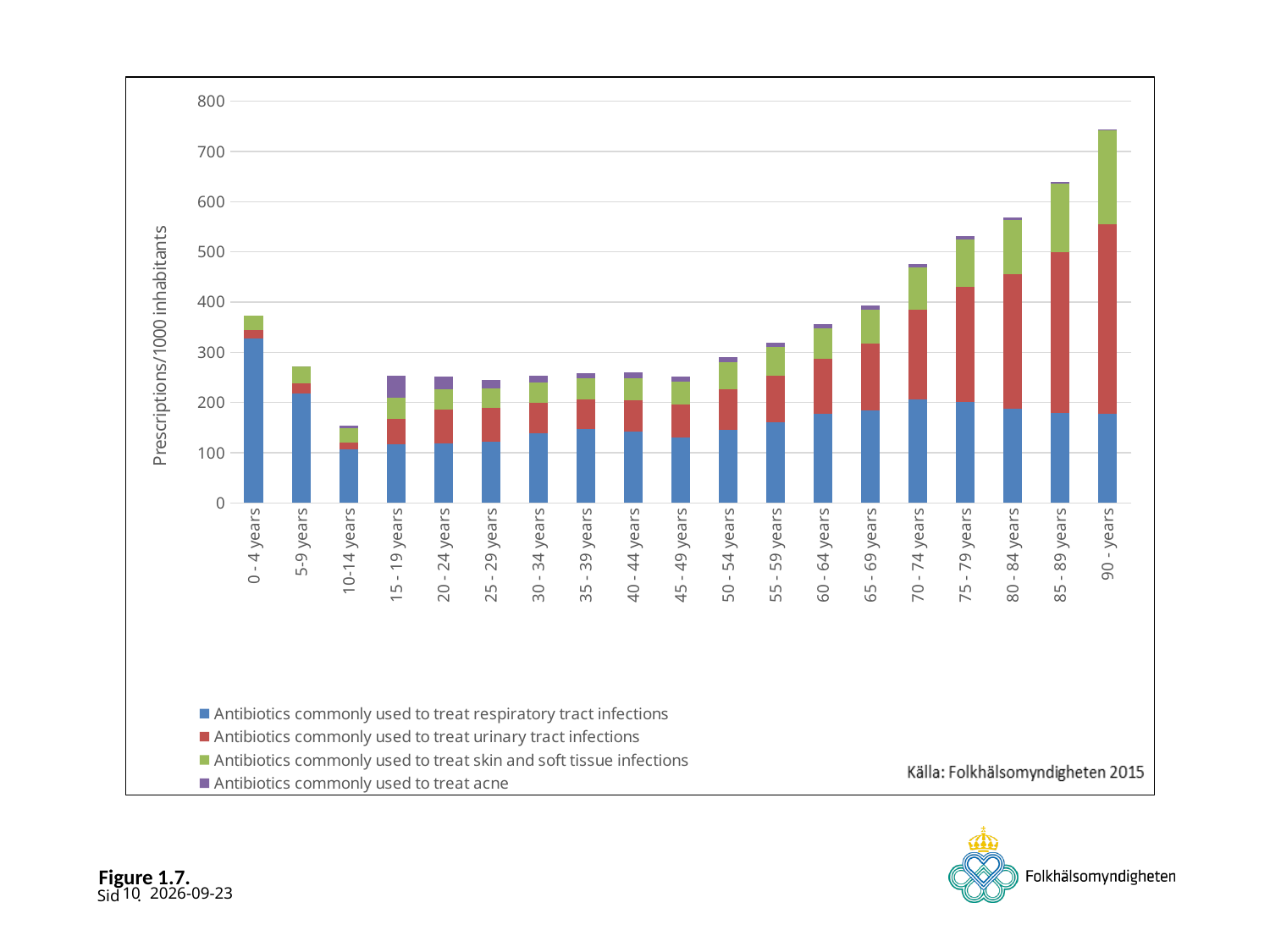
Is the total value for 90 - years greater or less than 700? greater Is the total value for 10-14 years greater or less than 200? less How many age-group categories are shown on the x axis? 19 What kind of chart is shown on the slide? Stacked bar chart Which age group has the highest value for antibiotics commonly used to treat respiratory tract infections? 0 - 4 years How many series does the legend list? 4 Which age group has the lowest total prescriptions per 1000 inhabitants? 10-14 years Is the total value for 85 - 89 years greater or less than 600? greater Which age group has the highest total prescriptions per 1000 inhabitants? 90 - years Which has the larger total, 0 - 4 years or 5-9 years? 0 - 4 years What is the title of the y axis? Prescriptions/1000 inhabitants Do the total prescriptions rise or fall across the age groups from 50 - 54 years to 90 - years? rise